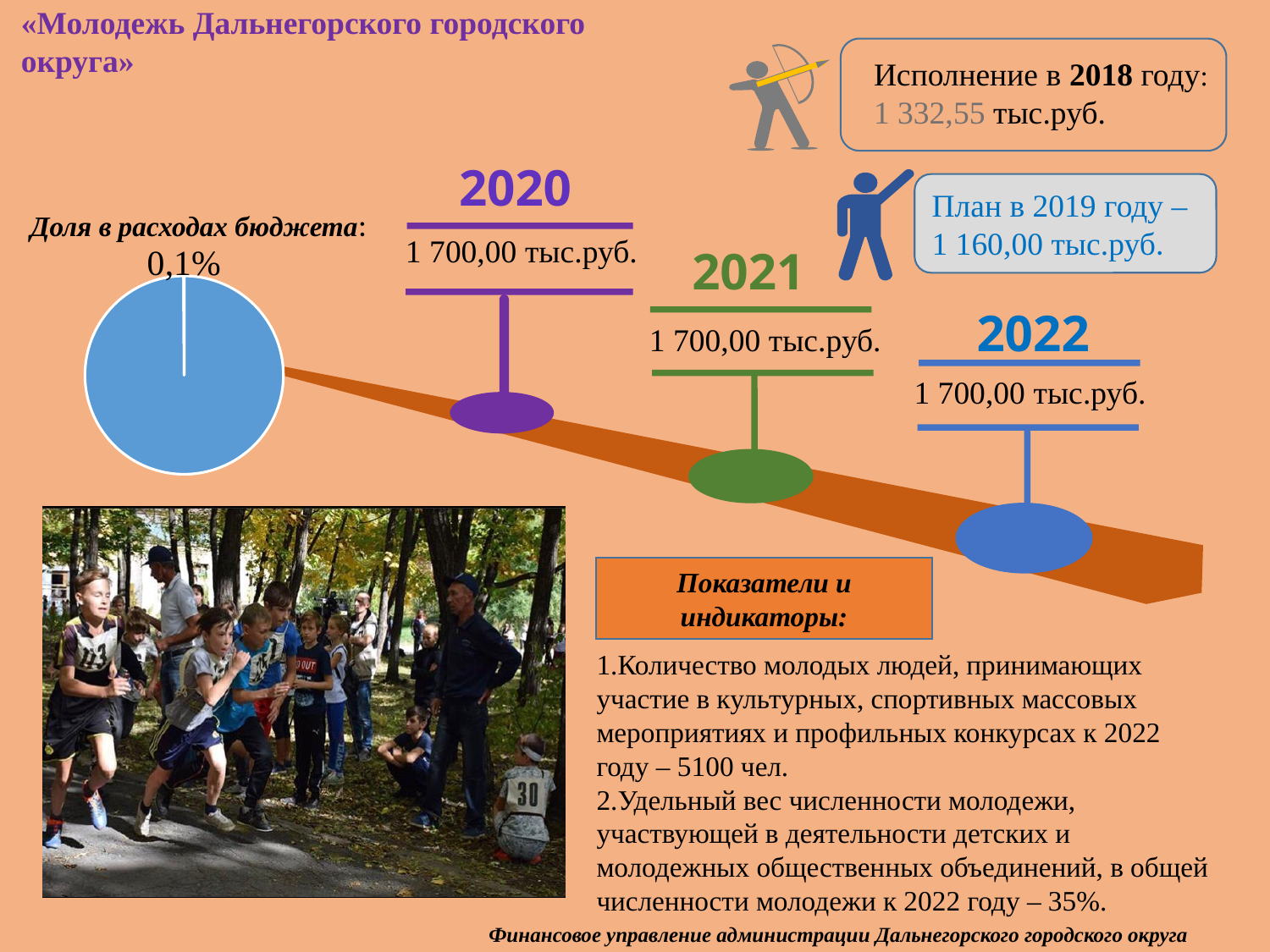
What colour is the pie chart filled with? blue What share is printed above the pie chart for "Доля в расходах бюджета"? 0,1% What kind of chart is shown on the left side of the slide? pie chart Is the share shown on the pie chart greater or less than 1%? less What is the label written above the pie chart? Доля в расходах бюджета